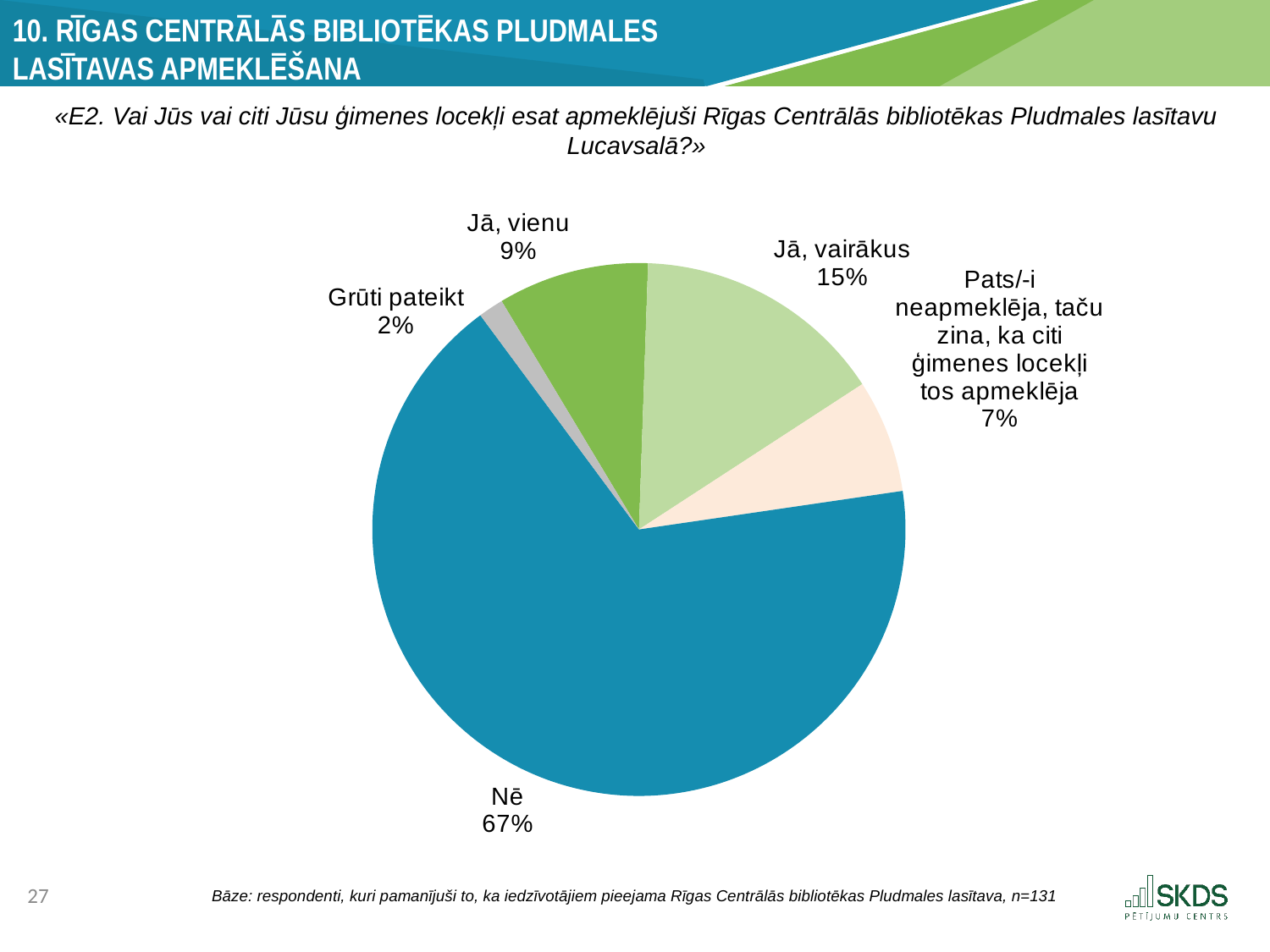
What is the difference in percentage points between "Jā, vairākus" and "Jā, vienu"? 6 percentage points What share of respondents answered "Grūti pateikt"? 2% What kind of chart is shown on the slide? pie chart Which answer category has the largest slice of the pie? Nē How many slices does the pie chart have? 5 What share of respondents answered "Jā, vairākus"? 15% What is the base size (n) stated at the bottom of the slide? n=131 Which answer category has the smallest slice of the pie? Grūti pateikt Which is larger: the share for "Jā, vienu" or the share for "Pats/-i neapmeklēja, taču zina, ka citi ģimenes locekļi tos apmeklēja"? Jā, vienu What share of respondents answered "Pats/-i neapmeklēja, taču zina, ka citi ģimenes locekļi tos apmeklēja"? 7% What share of respondents answered "Nē"? 67% What share of respondents answered "Jā, vienu"? 9%